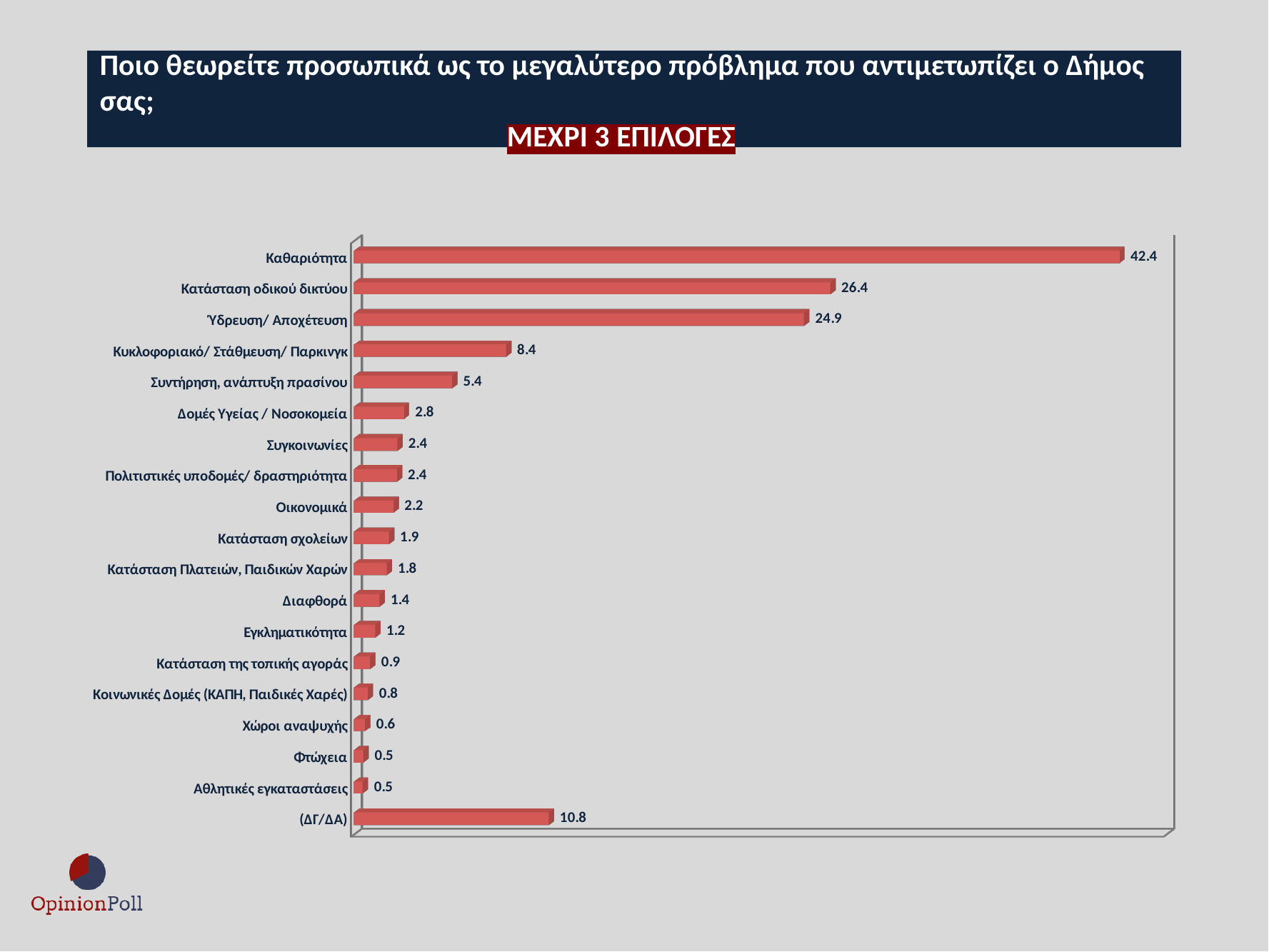
What kind of chart is shown on the slide? Bar chart What is the subtitle shown below the question title on the slide? ΜΕΧΡΙ 3 ΕΠΙΛΟΓΕΣ What value is shown for Ύδρευση/ Αποχέτευση? 24.9 What is the difference between the values for Καθαριότητα and Κατάσταση οδικού δικτύου? 16.0 How many categories are shown in the chart? 19 Which is larger, the value for (ΔΓ/ΔΑ) or the value for Κυκλοφοριακό/ Στάθμευση/ Παρκινγκ? (ΔΓ/ΔΑ) Which is larger, the value for Κατάσταση οδικού δικτύου or the value for Ύδρευση/ Αποχέτευση? Κατάσταση οδικού δικτύου What is the difference between the values for Κυκλοφοριακό/ Στάθμευση/ Παρκινγκ and Συντήρηση, ανάπτυξη πρασίνου? 3.0 What value is shown for Διαφθορά? 1.4 What value is shown for (ΔΓ/ΔΑ)? 10.8 Which category has the highest value? Καθαριότητα What value is shown for Καθαριότητα? 42.4